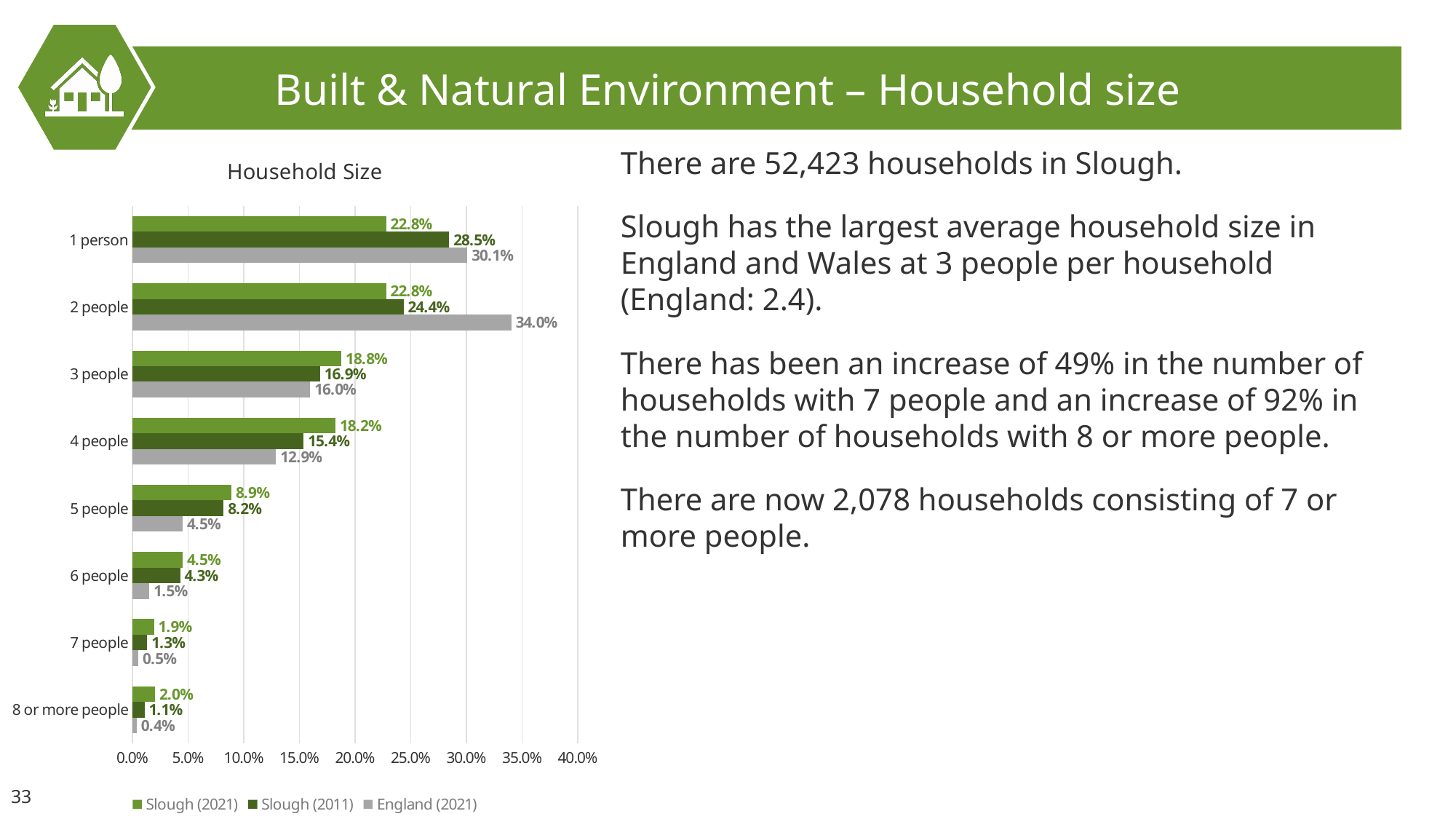
How many household size categories are shown on the chart? 8 What is the title of the chart? Household Size What is the value for 1 person in the Slough (2011) series? 28.5% Is the Slough (2011) value for 2 people greater or less than 20.0%? greater Which category has the highest value in the England (2021) series? 2 people Which is larger for 4 people: Slough (2021) or England (2021)? Slough (2021) Which category has the lowest value in the Slough (2011) series? 8 or more people What is the value for 2 people in the England (2021) series? 34.0% What is the value for 5 people in the Slough (2021) series? 8.9% How many series does the legend list? 3 What is the difference between the England (2021) and Slough (2021) values for 2 people? 11.2% What kind of chart is shown on the slide? Bar chart